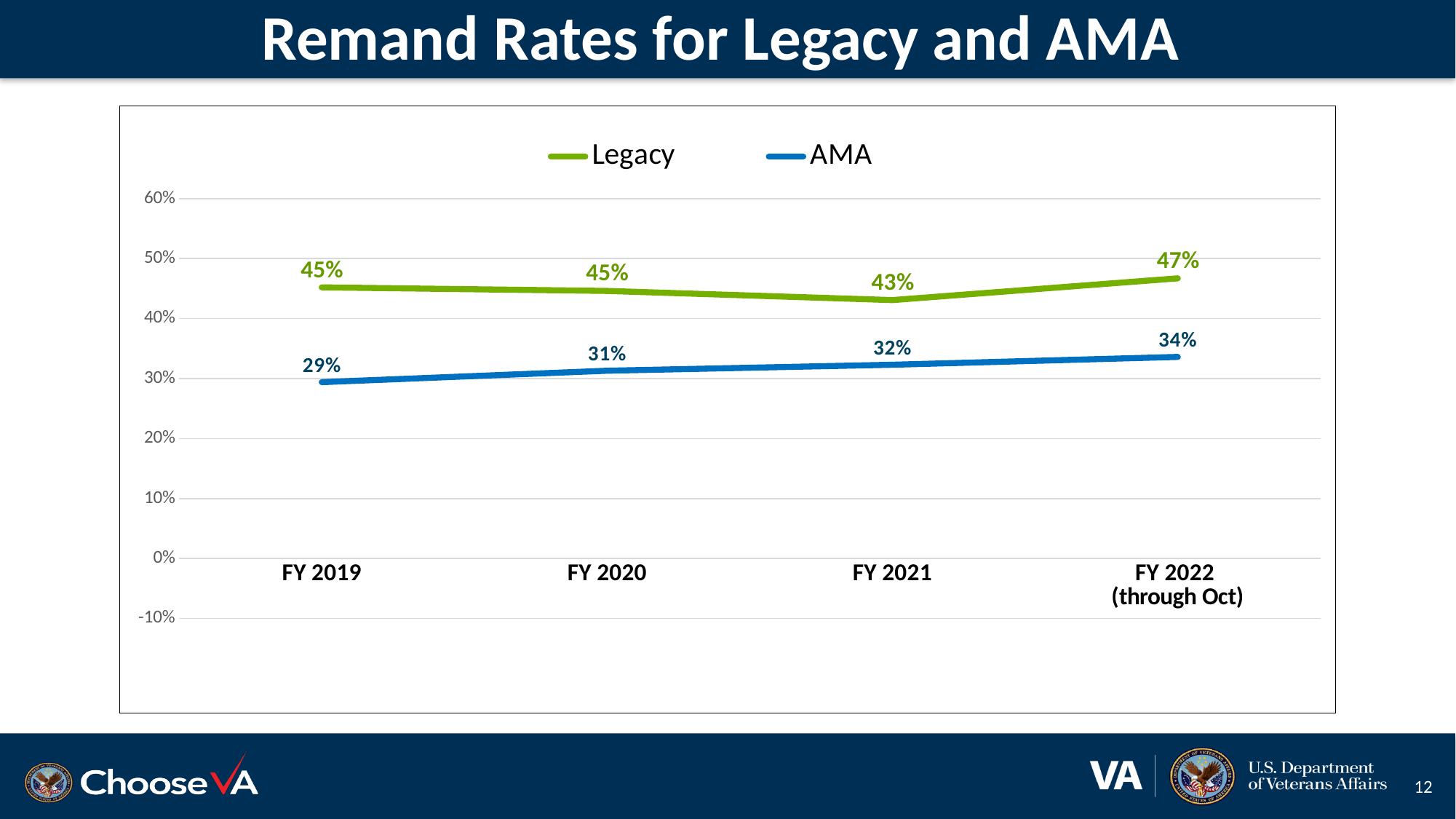
How many fiscal years are shown on the x axis? 4 What is the AMA remand rate for FY 2022 (through Oct)? 34% How many series does the legend list? 2 What is the Legacy remand rate for FY 2019? 45% Does the AMA remand rate rise or fall from FY 2019 to FY 2022 (through Oct)? Rise What is the difference between the Legacy and AMA remand rates in FY 2022 (through Oct)? 13% What is the AMA remand rate for FY 2021? 32% In which fiscal year is the AMA remand rate highest? FY 2022 (through Oct) What is the difference between the Legacy and AMA remand rates in FY 2019? 16% In which fiscal year is the Legacy remand rate lowest? FY 2021 What kind of chart is shown on the slide? Line chart Which series has the higher remand rate in FY 2020, Legacy or AMA? Legacy